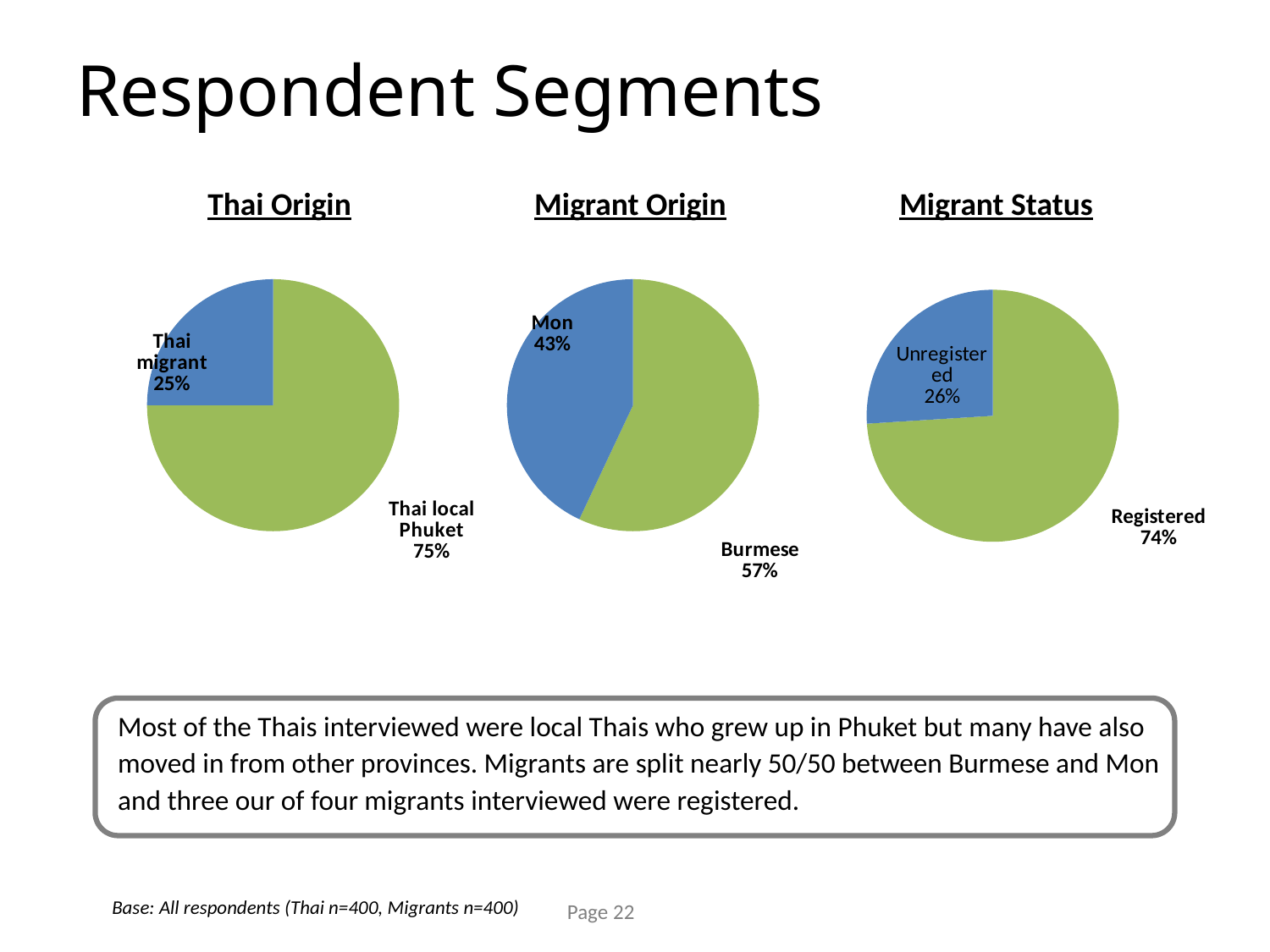
In the Migrant Origin chart, which slice is larger, Burmese or Mon? Burmese How many slices does the Thai Origin chart have? 2 In the Migrant Status chart, what share of respondents are Unregistered? 26% In the Thai Origin chart, what share of respondents are Thai migrant? 25% In the Thai Origin chart, what share of respondents are Thai local Phuket? 75% In the Migrant Status chart, what share of respondents are Registered? 74% In the Migrant Status chart, what is the difference in percentage points between Registered and Unregistered? 48 In the Thai Origin chart, which slice is the smallest? Thai migrant In the Migrant Origin chart, what share of respondents are Mon? 43% In the Migrant Origin chart, what share of respondents are Burmese? 57% In the Migrant Origin chart, what is the difference in percentage points between the Burmese and Mon slices? 14 What kind of chart is used for the Migrant Status chart? Pie chart